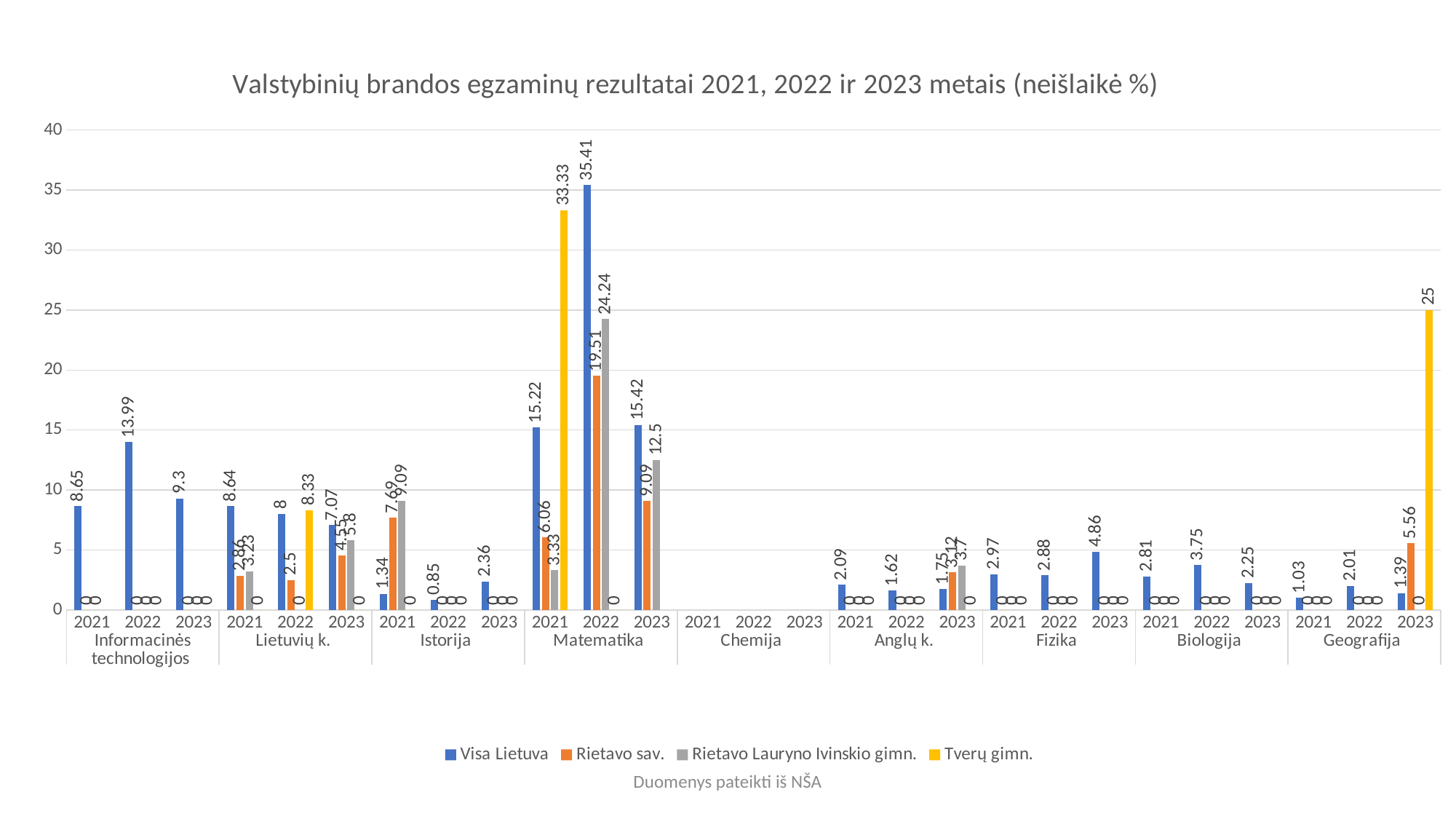
In Matematika 2022, which is larger: Rietavo sav. or Rietavo Lauryno Ivinskio gimn.? Rietavo Lauryno Ivinskio gimn. Which bar has the highest value on the whole chart? Visa Lietuva, Matematika 2022 (35.41) What is the value for Visa Lietuva in Istorija for 2022? 0.85 What is the value for Tverų gimn. in Geografija for 2023? 25 What is the difference between the Visa Lietuva values for Informacinės technologijos in 2022 and 2021? 5.34 How many series does the legend list? 4 What is the value for Rietavo sav. in Geografija for 2023? 5.56 What is the value for Tverų gimn. in Matematika for 2021? 33.33 How many subjects are shown along the x axis? 9 Do the Visa Lietuva values for Lietuvių k. rise or fall from 2021 to 2023? Fall What kind of chart is shown on the slide? Bar chart What is the value for Visa Lietuva in Matematika for 2022? 35.41